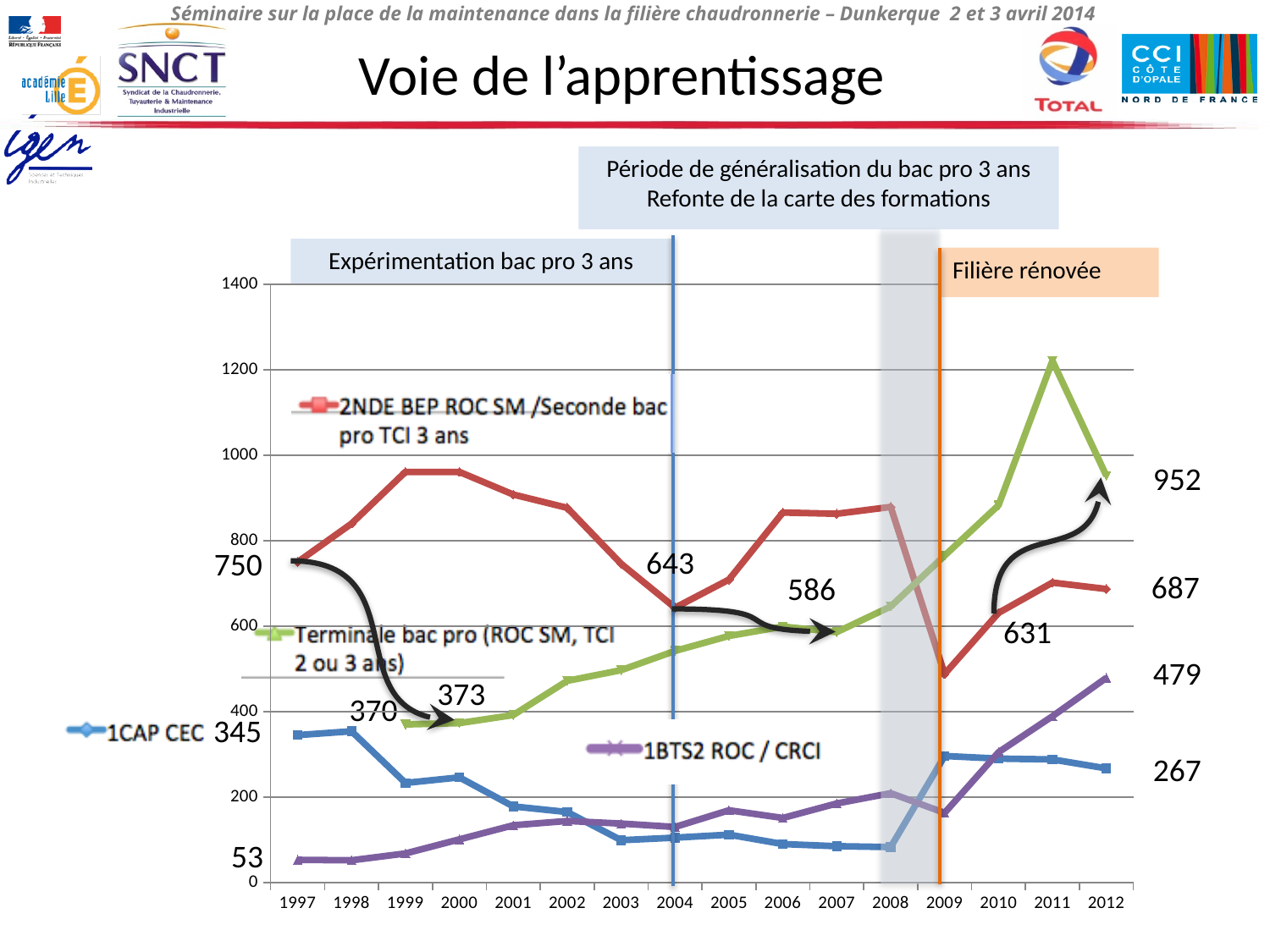
Which series has the highest value in 2012? Terminale bac pro (ROC SM, TCI 2 ou 3 ans) What is the value of the Terminale bac pro series in 2012? 952 How many years are shown along the x axis of the chart? 16 What is the value of the 2NDE BEP ROC SM / Seconde bac pro TCI 3 ans series in 1997? 750 What is the value of the 1BTS2 ROC / CRCI series in 2012? 479 How many series are plotted on the chart? 4 What is the value of the 2NDE BEP ROC SM / Seconde bac pro TCI 3 ans series in 2012? 687 Is the value of the 2NDE BEP ROC SM / Seconde bac pro TCI 3 ans series in 2000 greater or less than 800? greater Does the 1BTS2 ROC / CRCI series rise or fall between 2009 and 2012? Rise What kind of chart is shown on the slide? Line chart What is the value of the 1CAP CEC series in 1997? 345 What is the difference between the Terminale bac pro value and the 2NDE BEP ROC SM / Seconde bac pro TCI 3 ans value in 2012? 265